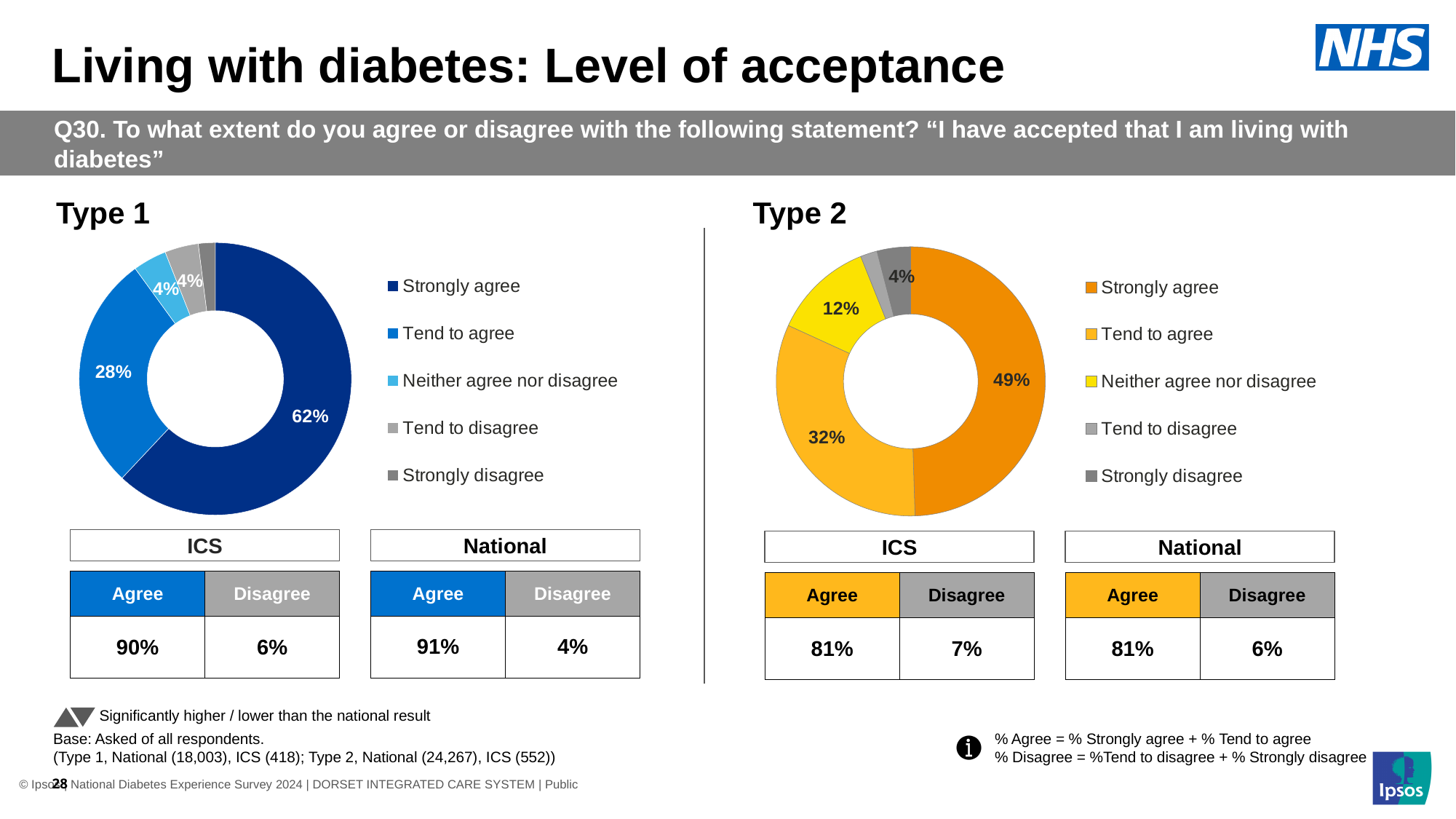
In the Type 1 chart, which response category has the largest share? Strongly agree In the Type 2 chart, what colour represents Neither agree nor disagree? Yellow In the Type 1 chart, what percentage of respondents strongly agree? 62% In the Type 2 chart, what percentage of respondents tend to agree? 32% In the Type 1 chart, what is the difference in percentage points between Strongly agree and Tend to agree? 34 How many response categories does the legend of the Type 2 chart list? 5 In the Type 1 chart, what percentage of respondents tend to agree? 28% In the Type 2 chart, what is the difference in percentage points between Strongly agree and Tend to agree? 17 What kind of chart is used for Type 1? Donut (pie) chart Which chart has the larger Strongly agree share, Type 1 or Type 2? Type 1 In the Type 2 chart, what percentage neither agree nor disagree? 12% In the Type 2 chart, which response category has the largest share? Strongly agree